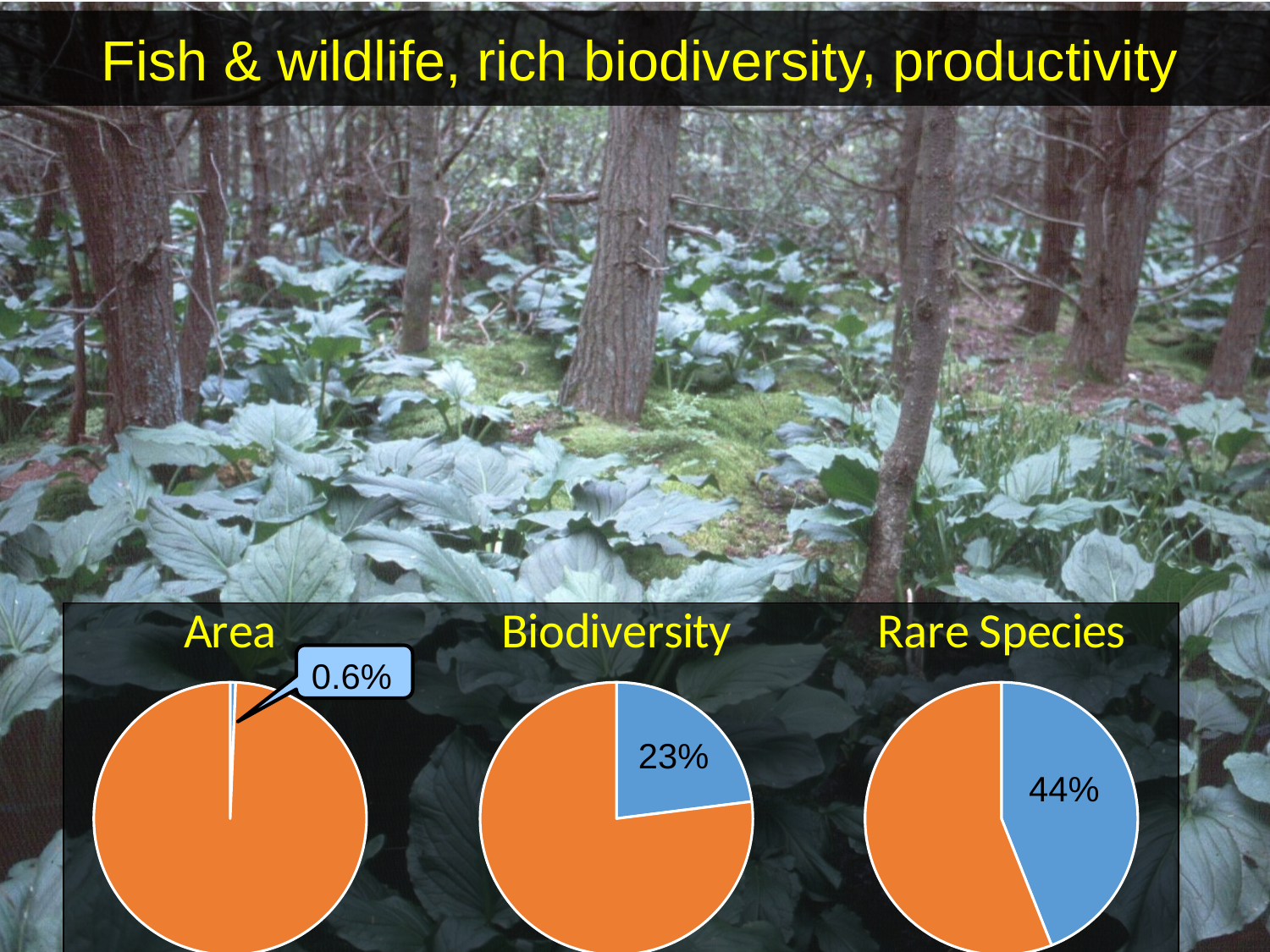
How many slices does the Rare Species pie chart have? 2 In the Rare Species pie chart, what share is shown for the blue slice? 44% In the Biodiversity pie chart, is the blue slice greater or less than 50%? less What is the difference between the blue slice share in the Rare Species pie chart and the blue slice share in the Biodiversity pie chart? 21% Which of the three pie charts has the largest blue slice? Rare Species What colour is the larger slice in each of the three pie charts? Orange Which of the three pie charts has the smallest blue slice? Area What kind of chart is the Biodiversity chart? Pie chart Is the blue slice larger in the Biodiversity pie chart or the Rare Species pie chart? Rare Species In the Area pie chart, what share is shown for the blue slice? 0.6% In the Biodiversity pie chart, what share is shown for the blue slice? 23% How many pie charts are shown on the slide? 3